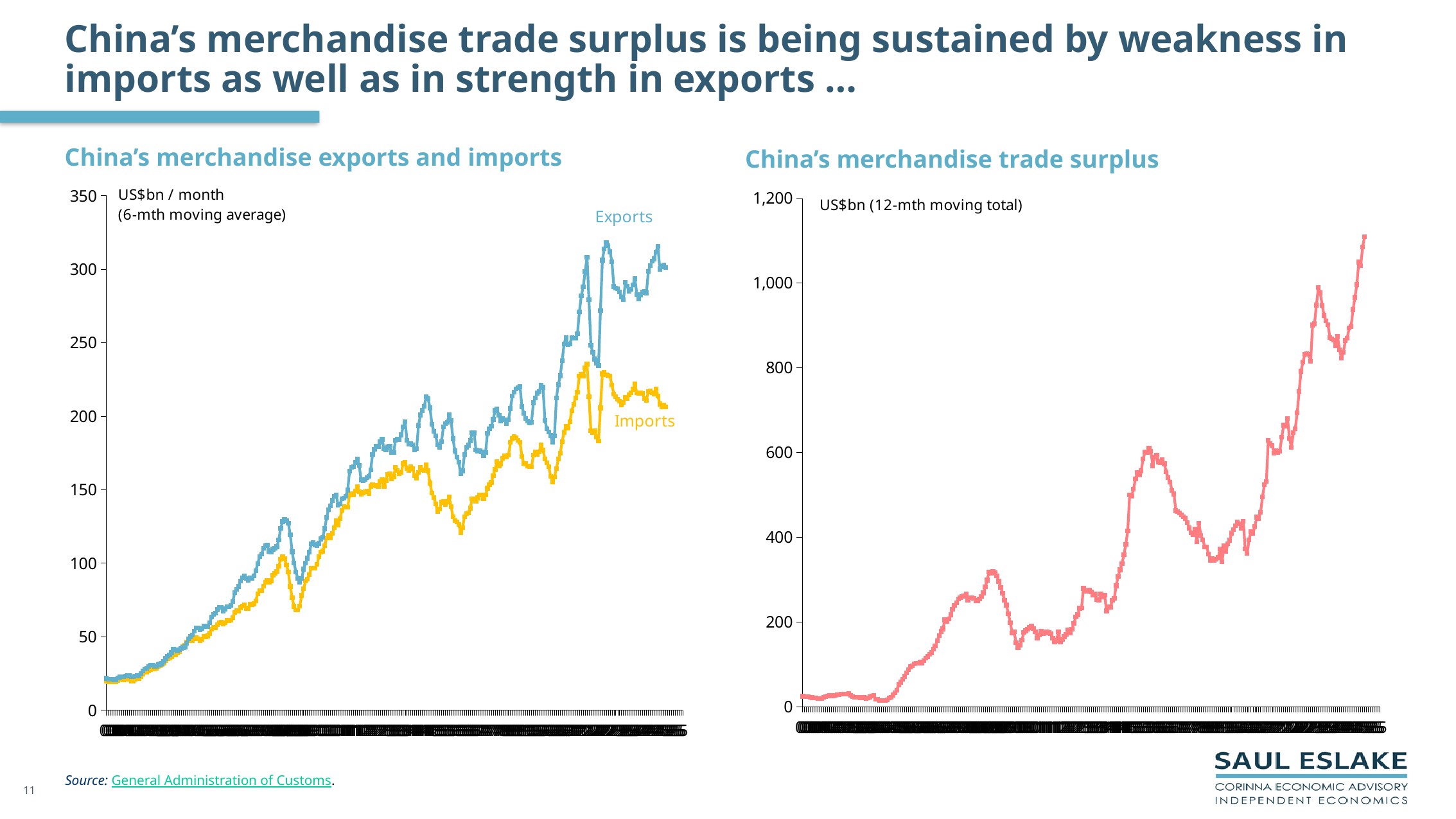
On the 'China's merchandise trade surplus' chart, does the line generally rise or fall from left to right? rise On the 'China's merchandise exports and imports' chart, what unit is shown on the y axis? US$bn / month (6-mth moving average) What kind of chart is the 'China's merchandise exports and imports' chart? line chart On the 'China's merchandise trade surplus' chart, is the value at the left-hand start of the line greater or less than 200? less How many series are plotted on the 'China's merchandise trade surplus' chart? 1 What kind of chart is the 'China's merchandise trade surplus' chart? line chart On the 'China's merchandise exports and imports' chart, is the latest value for Exports greater or less than 250? greater On the 'China's merchandise trade surplus' chart, is the value at the right-hand end of the line greater or less than 1,000? greater How many series are plotted on the 'China's merchandise exports and imports' chart? 2 On the 'China's merchandise trade surplus' chart, what unit is shown on the y axis? US$bn (12-mth moving total) On the 'China's merchandise exports and imports' chart, which series is higher at the right-hand end of the chart, Exports or Imports? Exports